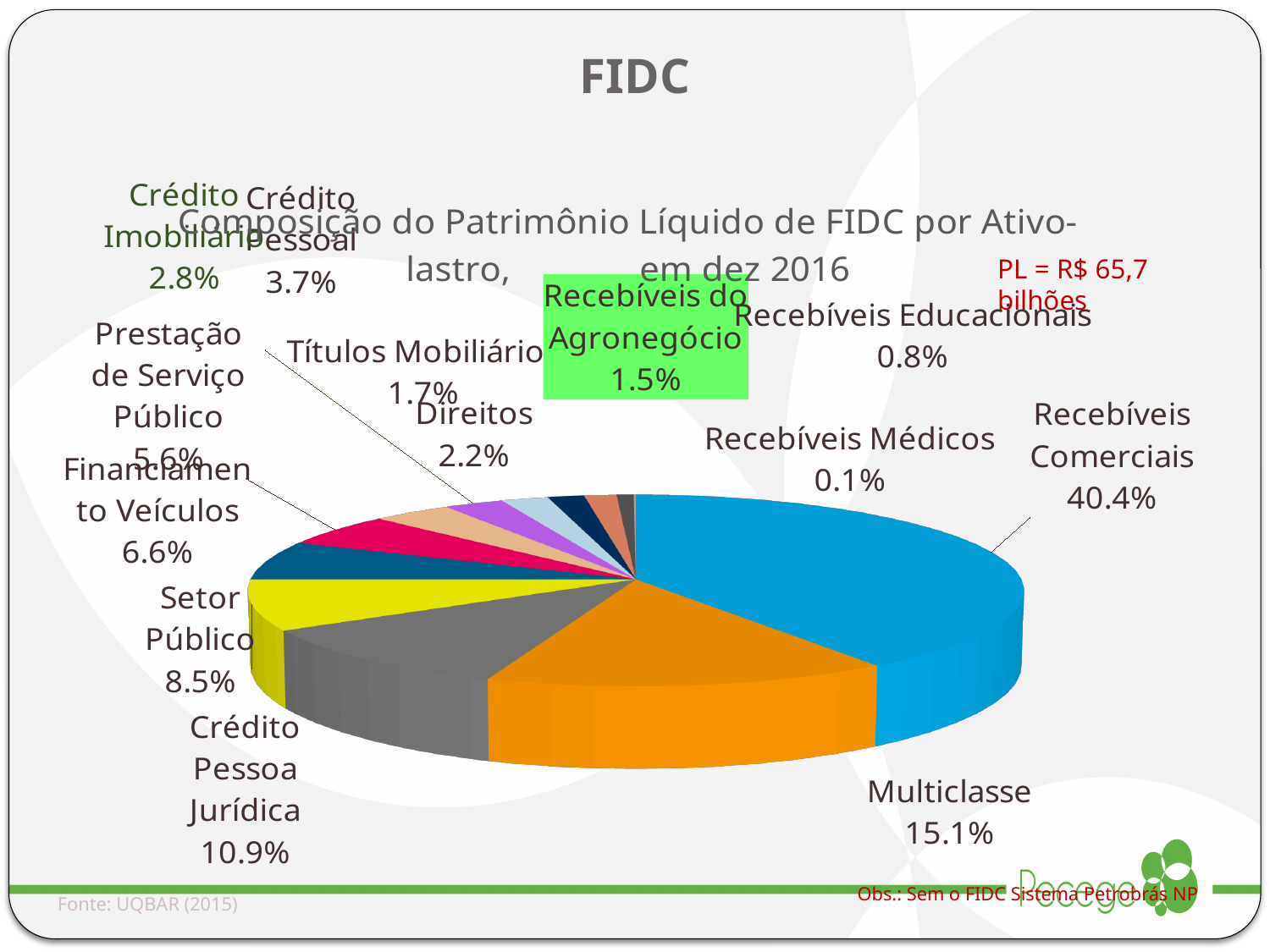
What is the share for Recebíveis do Agronegócio? 1.5% What is the share for Setor Público? 8.5% How many categories are shown in the pie chart? 13 Which category has the smallest share of the pie? Recebíveis Médicos What kind of chart is shown on the slide? pie chart What is the title of the chart? Composição do Patrimônio Líquido de FIDC por Ativo-lastro, em dez 2016 What total PL value is noted on the slide next to the chart? R$ 65,7 bilhões What is the difference between the shares of Recebíveis Comerciais and Multiclasse? 25.3% What is the share for Crédito Pessoa Jurídica? 10.9% What is the share for Multiclasse? 15.1% Which category has the largest share of the pie? Recebíveis Comerciais Which is larger, the share for Financiamento Veículos or the share for Prestação de Serviço Público? Financiamento Veículos